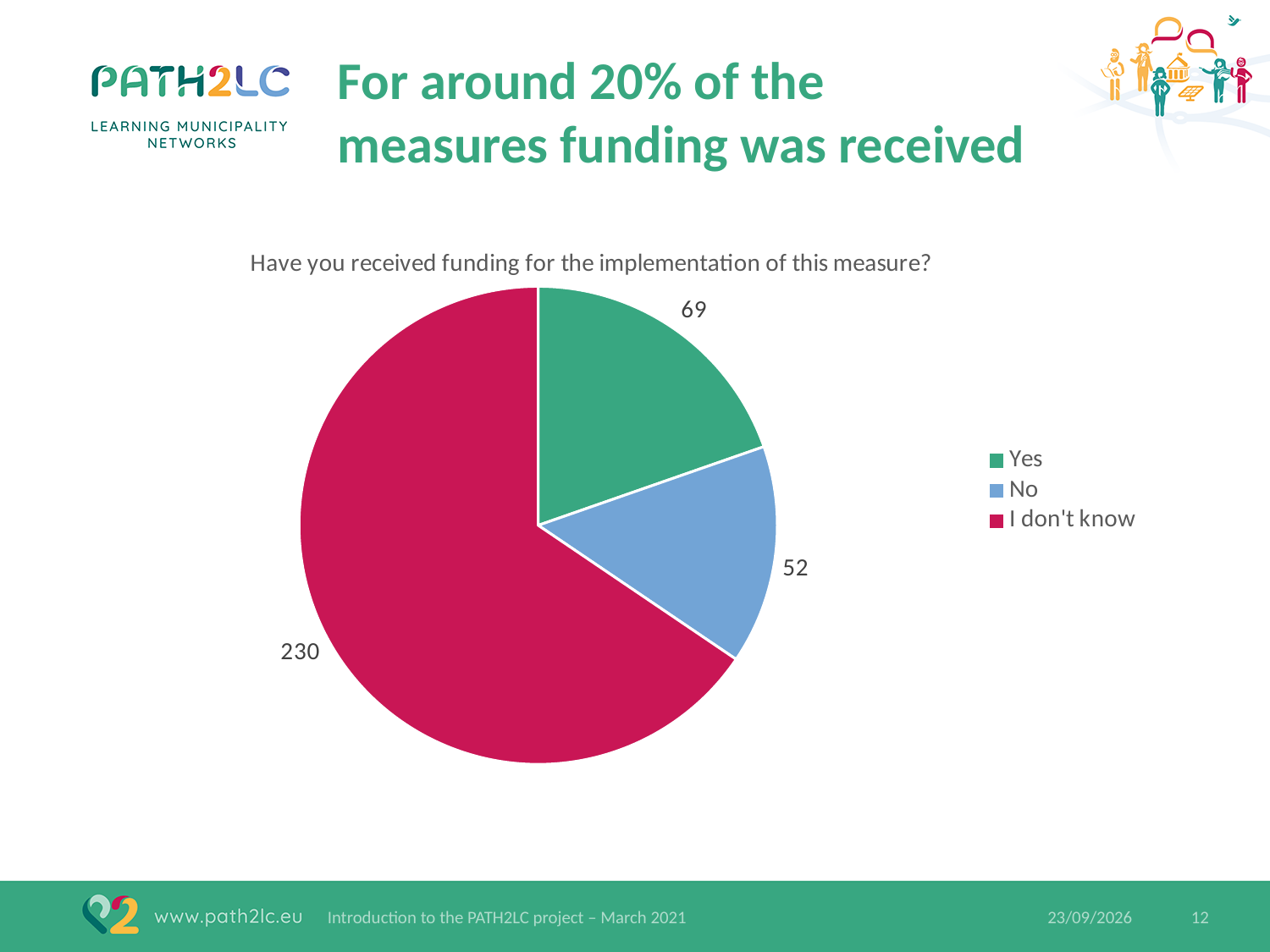
What is the total of all the slices in the pie chart? 351 What is the difference between the 'Yes' value and the 'No' value? 17 Which category has the smallest slice in the pie chart? No Which category has the largest slice in the pie chart? I don't know What is the value for the 'I don't know' slice in the pie chart? 230 What is the difference between the 'I don't know' value and the 'Yes' value? 161 What is the value for the 'No' slice in the pie chart? 52 How many categories does the pie chart show? 3 What is the value for the 'Yes' slice in the pie chart? 69 What is the title of the chart on the slide? Have you received funding for the implementation of this measure? Which is larger, the 'Yes' slice or the 'No' slice? Yes What type of chart is shown on the slide? Pie chart